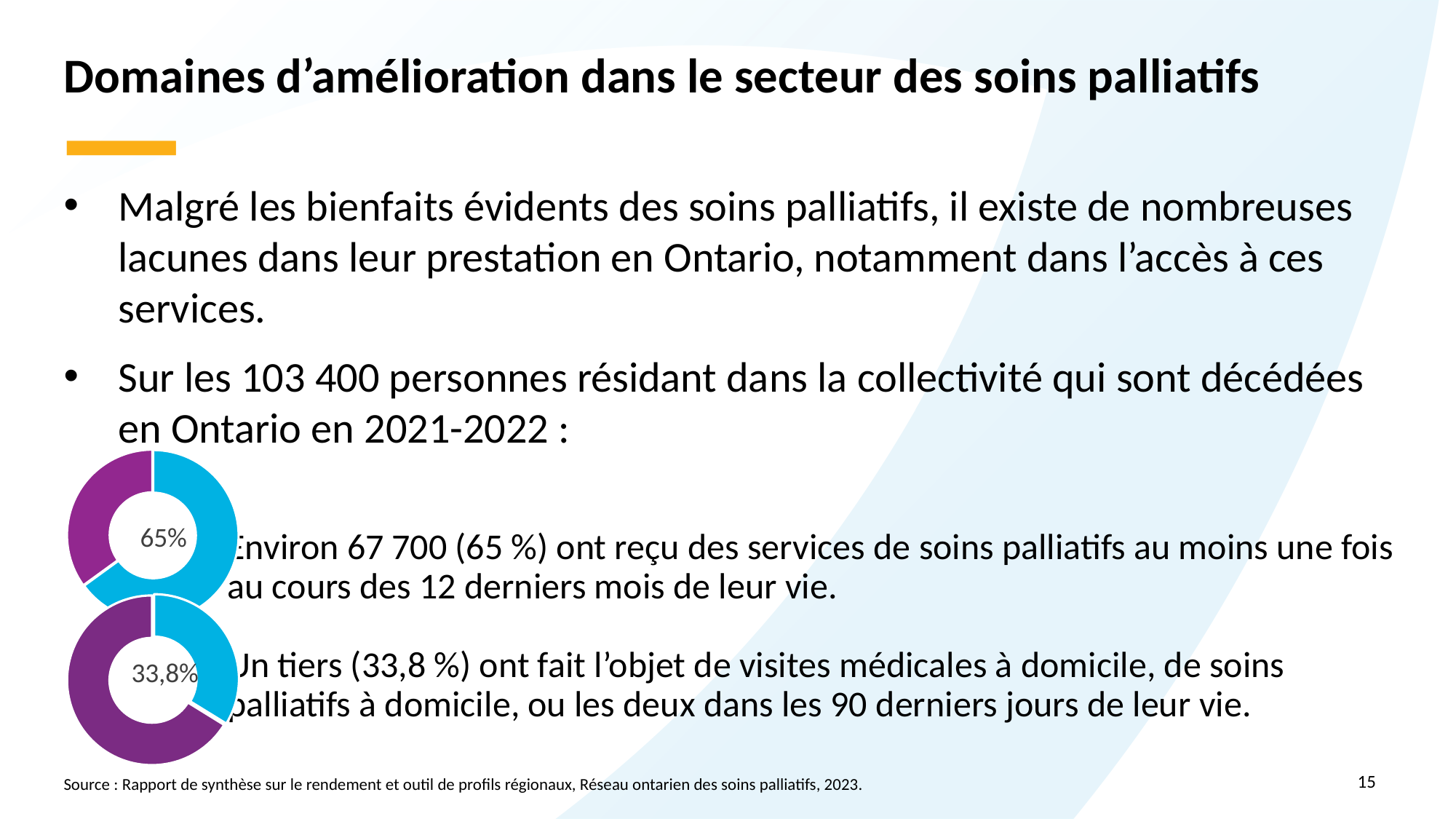
Which colour represents the 65% share in the upper donut chart? blue Which colour is the larger segment in the lower donut chart? purple How many segments does the lower donut chart have? 2 Is the value shown in the lower donut chart greater or less than 50%? less What value is printed in the centre of the lower donut chart? 33,8% Is the value shown in the upper donut chart greater or less than 50%? greater What kind of chart is the upper chart on the left of the slide? donut chart What is the difference between the value in the upper donut chart (65%) and the value in the lower donut chart (33,8%)? 31,2 % Which donut chart shows the larger printed value, the upper one or the lower one? the upper one In the upper donut chart, what share does the purple segment represent, given the blue segment is 65%? 35% How many donut charts are shown on the slide? 2 What value is printed in the centre of the upper donut chart? 65%